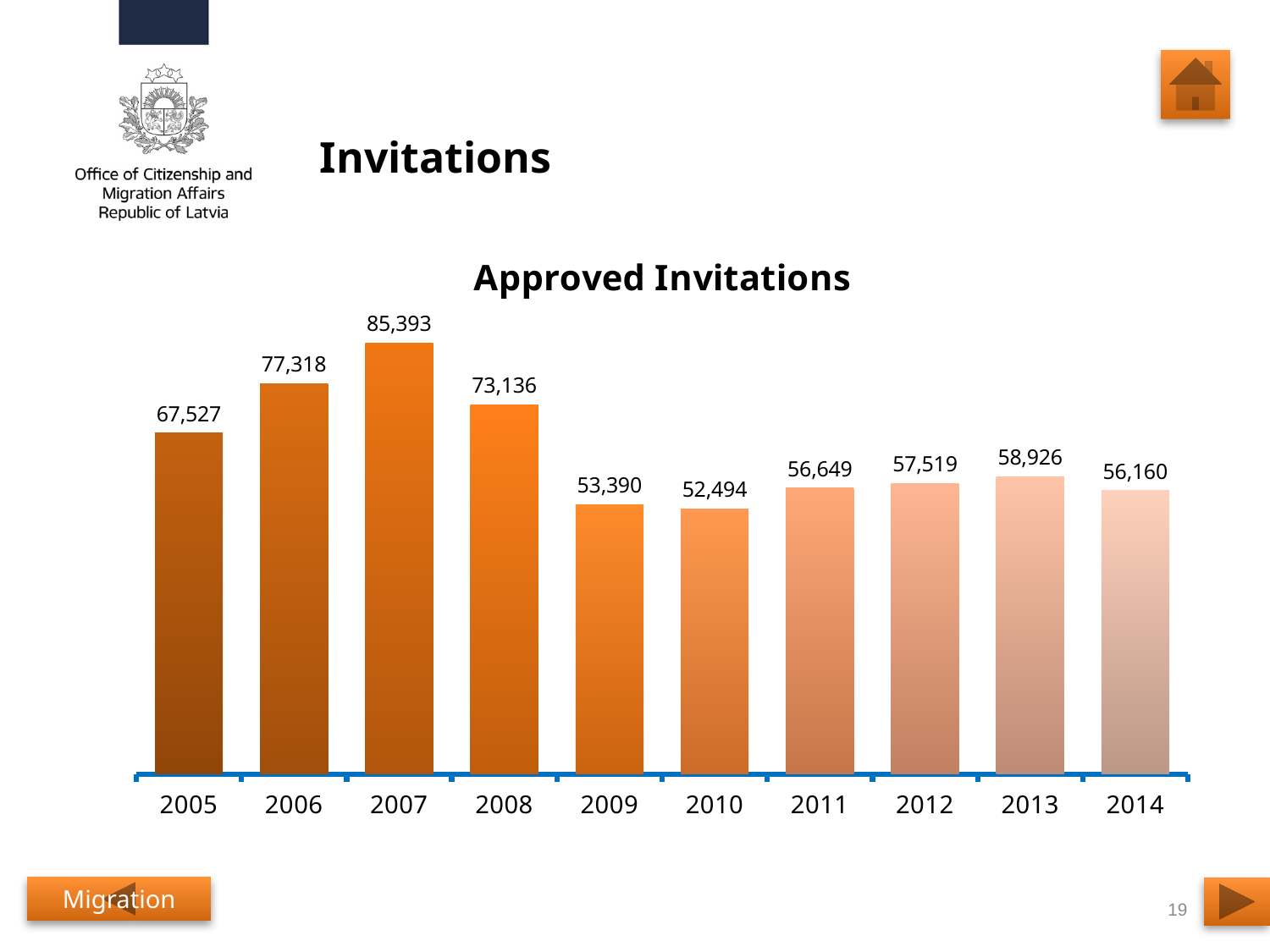
What is the value for 2007 in the Approved Invitations chart? 85,393 What is the title of the chart? Approved Invitations Which year has the lowest number of approved invitations? 2010 What kind of chart is shown on the slide? bar chart How many years are shown on the x axis of the chart? 10 What is the difference between the values for 2007 and 2008? 12,257 Which year has the highest number of approved invitations? 2007 What is the value for 2014 in the Approved Invitations chart? 56,160 Do the values rise or fall from 2008 to 2010? fall Which is larger, the value for 2012 or the value for 2013? 2013 What is the value for 2010 in the Approved Invitations chart? 52,494 What is the difference between the values for 2005 and 2014? 11,367